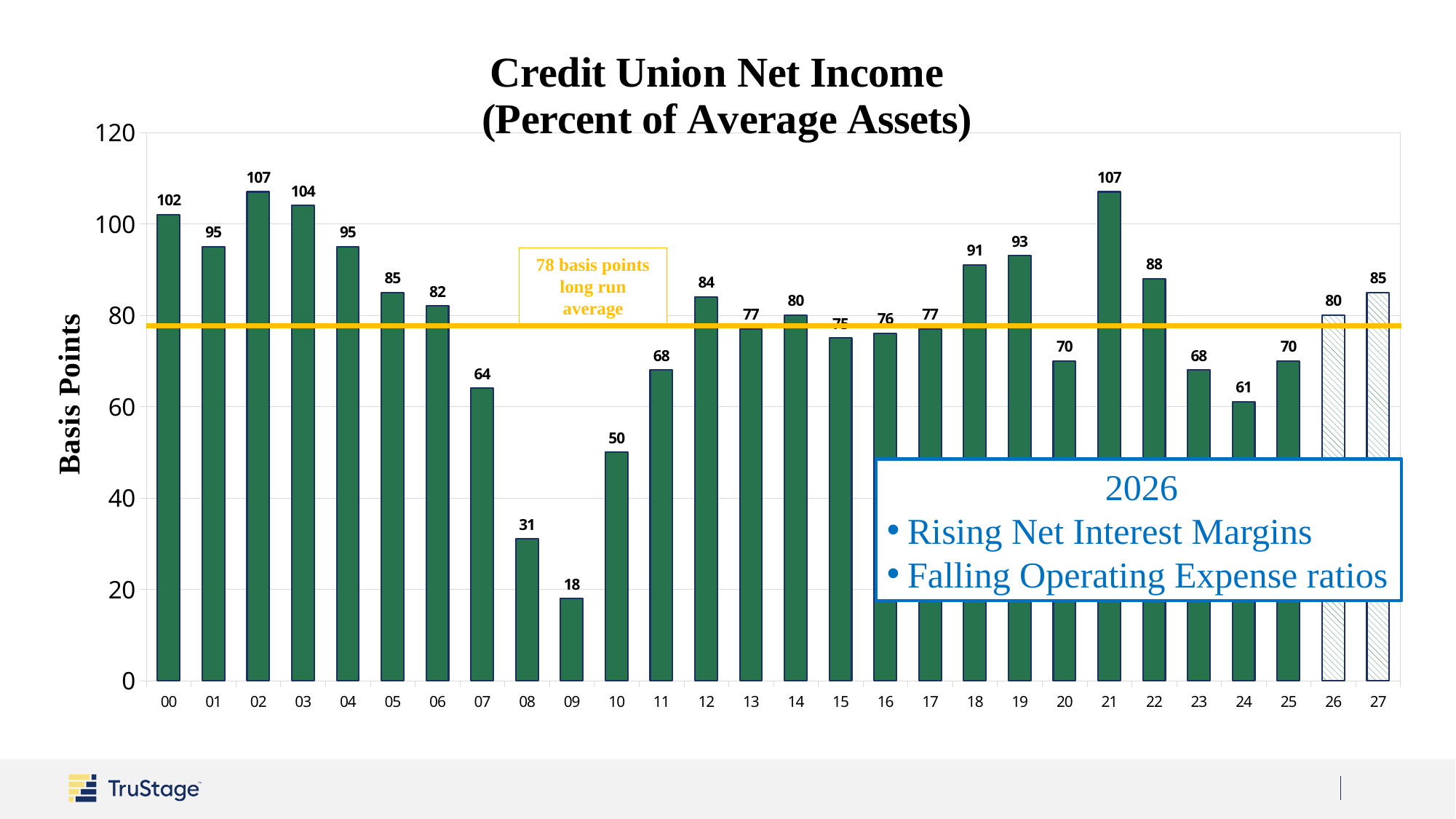
Which year has the lowest net income value in the chart? 09 What long run average value does the horizontal yellow line mark? 78 basis points What is the projected value for 27 in the Credit Union Net Income chart? 85 Which is larger, the value for 18 or the value for 19? 19 What is the difference between the values for 08 and 09? 13 Do the values rise or fall from 07 to 09? fall What is the value for 21 in the Credit Union Net Income chart? 107 What type of chart is shown on the slide? bar chart What is the value for 09 in the Credit Union Net Income chart? 18 What is the label on the vertical axis of the chart? Basis Points How many years (bars) are plotted in the chart? 28 What is the difference between the values for 22 and 23? 20